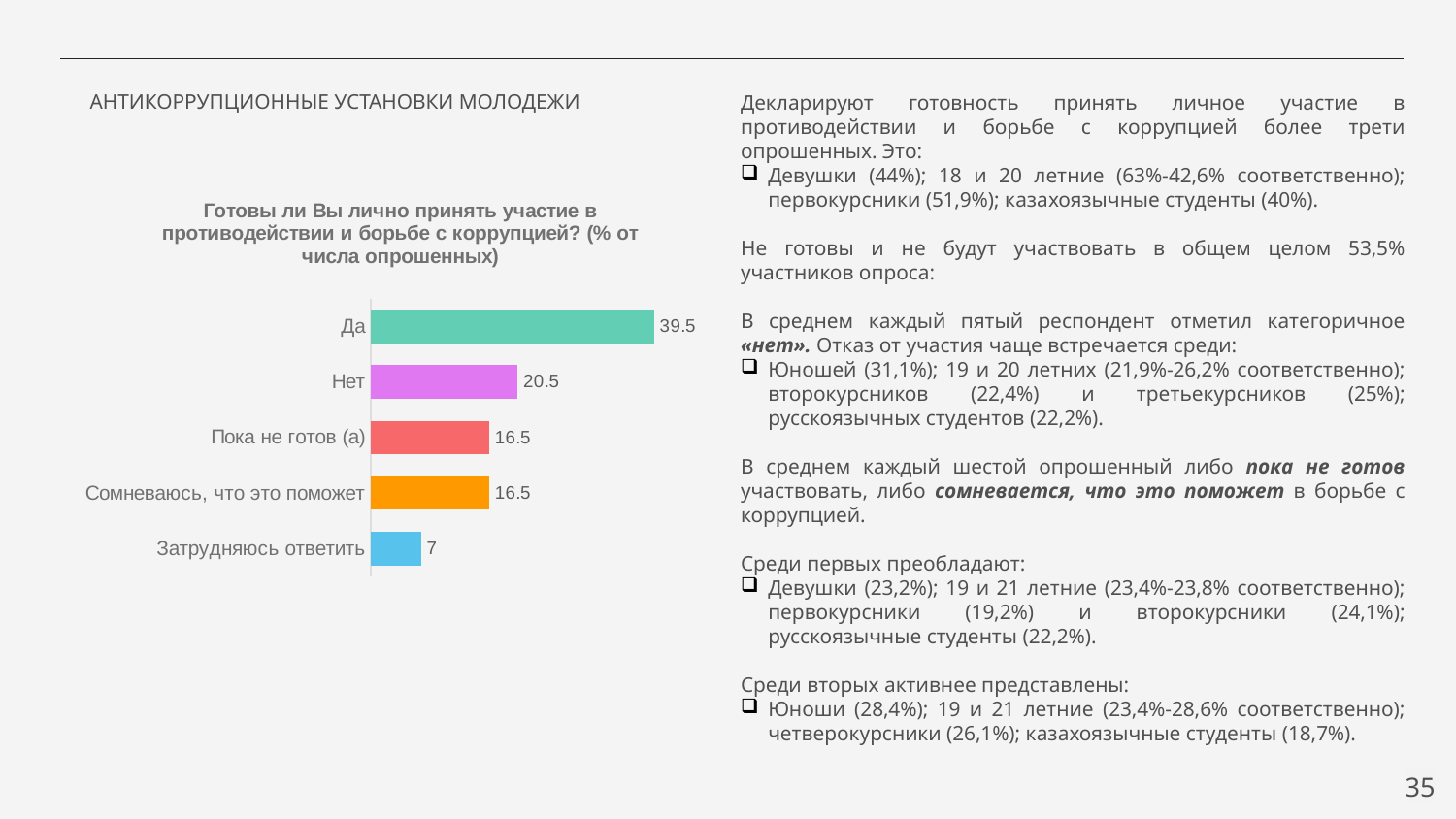
What is the difference between the values for "Да" and "Нет"? 19 What is the value for "Затрудняюсь ответить" in the chart? 7 Which is larger, the value for "Нет" or the value for "Затрудняюсь ответить"? Нет What kind of chart is shown on the slide? Bar chart What is the value for "Нет" in the chart? 20.5 What is the title of the chart? Готовы ли Вы лично принять участие в противодействии и борьбе с коррупцией? (% от числа опрошенных) How many categories are shown in the chart? 5 What is the value for "Сомневаюсь, что это поможет" in the chart? 16.5 What is the difference between the values for "Нет" and "Пока не готов (а)"? 4 Which category has the lowest value in the chart? Затрудняюсь ответить Which category has the highest value in the chart? Да What is the value for "Да" in the chart? 39.5